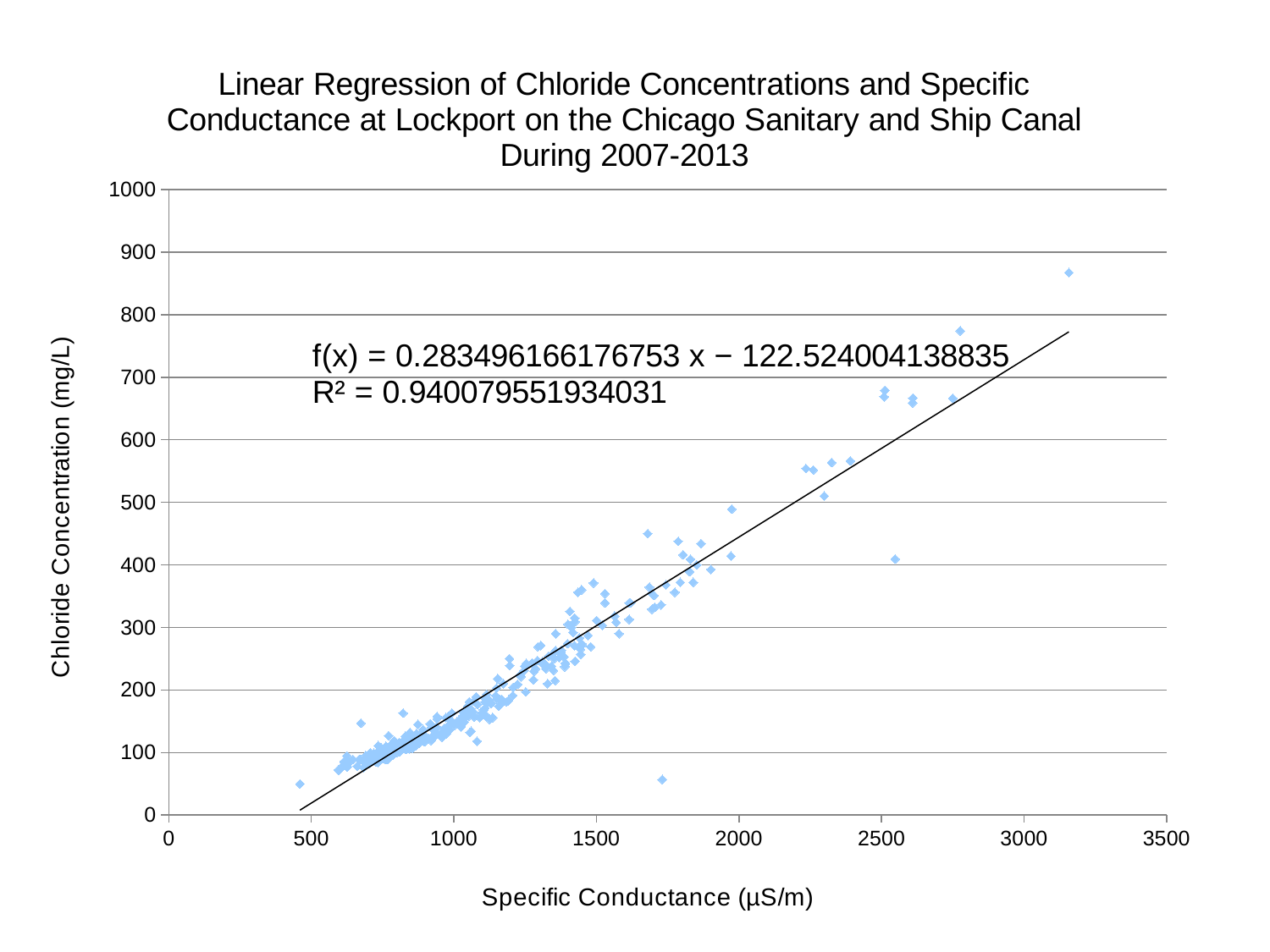
Is the chloride concentration of the isolated outlier point near 2500 µS/m greater or less than 500 mg/L? less Do chloride concentrations rise or fall as specific conductance increases along the x axis? Rise Is the chloride concentration of the leftmost plotted point (near 500 µS/m) greater or less than 100 mg/L? less What kind of chart is shown on the slide? Scatter plot Is the specific conductance of the rightmost plotted point greater or less than 3000 µS/m? greater What is the R² value printed on the chart? 0.940079551934031 What is the maximum value shown on the y axis? 1000 What is the regression equation printed on the chart? f(x) = 0.283496166176753 x − 122.524004138835